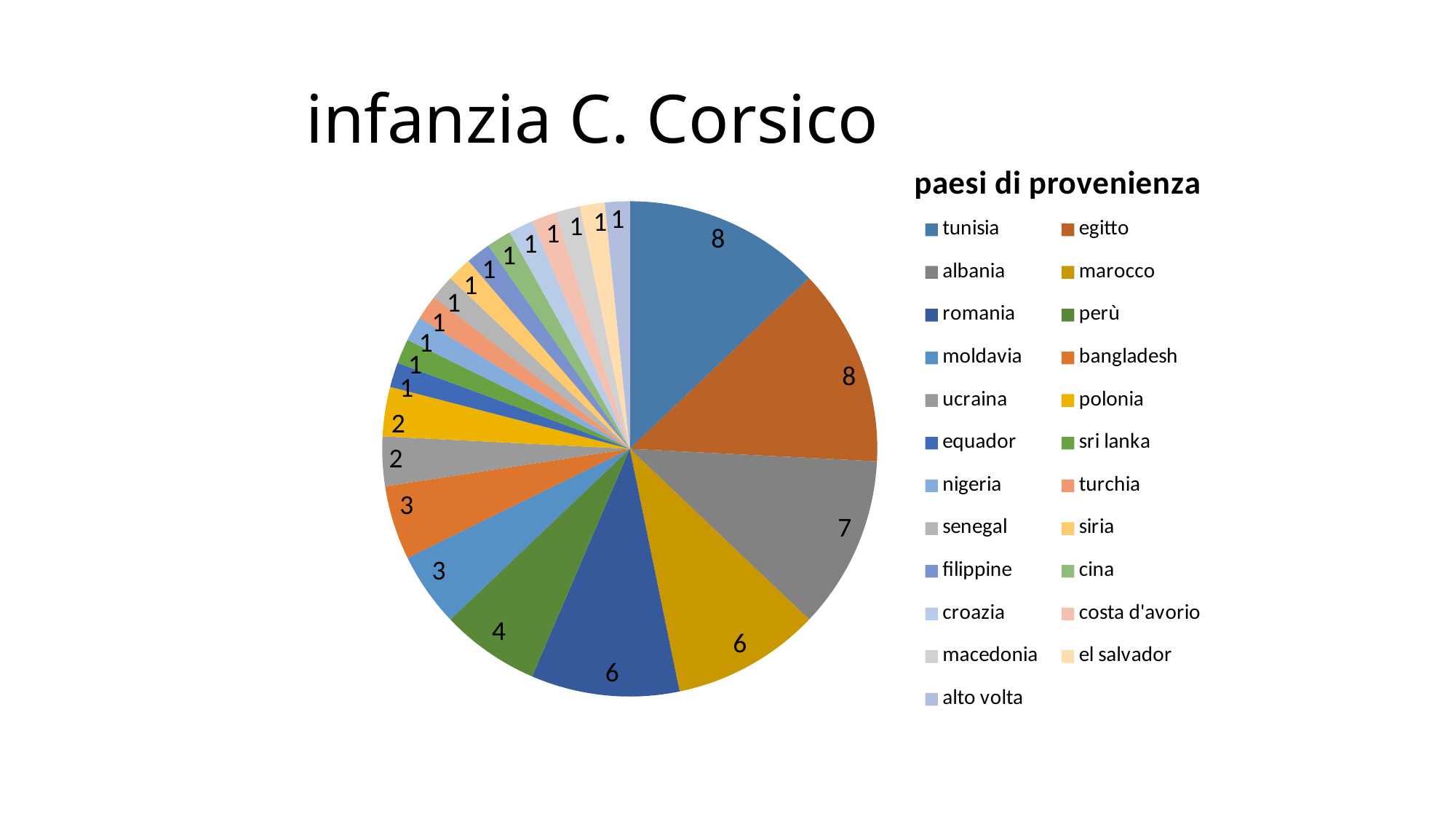
What is the difference between the value for tunisia and the value for perù? 4 What is the value for alto volta in the pie chart? 1 How many countries (categories) does the pie chart show? 23 What is the value for ucraina in the pie chart? 2 Which is larger, the value for albania or the value for perù? albania What is the value for perù in the pie chart? 4 What is the value for albania in the pie chart? 7 What is the value for moldavia in the pie chart? 3 What kind of chart is shown on the slide? pie chart What is the title of the pie chart's legend? paesi di provenienza What is the value for tunisia in the pie chart? 8 What is the difference between the value for marocco and the value for bangladesh? 3